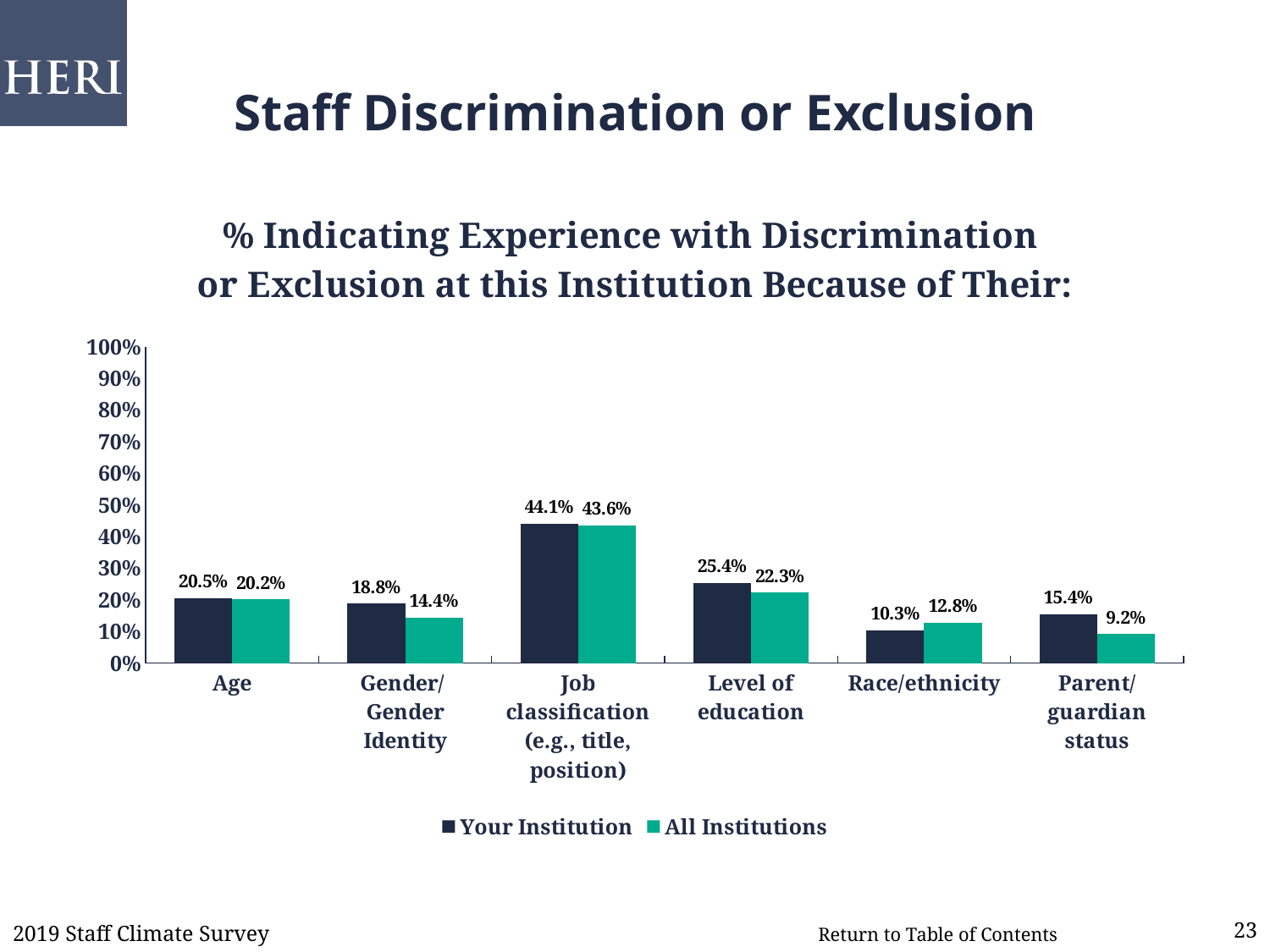
What kind of chart is shown on the slide? Bar chart What is the difference between Your Institution and All Institutions for Level of education? 3.1% What is the value for Your Institution for Race/ethnicity? 10.3% How many categories are shown on the x axis? 6 How many series does the legend list? 2 Which category has the highest value for All Institutions? Job classification (e.g., title, position) For Race/ethnicity, which is larger: Your Institution or All Institutions? All Institutions What is the difference between Your Institution and All Institutions for Parent/guardian status? 6.2% What is the value for Your Institution for Job classification (e.g., title, position)? 44.1% Is the value for Your Institution for Job classification greater or less than 40%? greater Which category has the lowest value for Your Institution? Race/ethnicity What is the value for All Institutions for Gender/Gender Identity? 14.4%